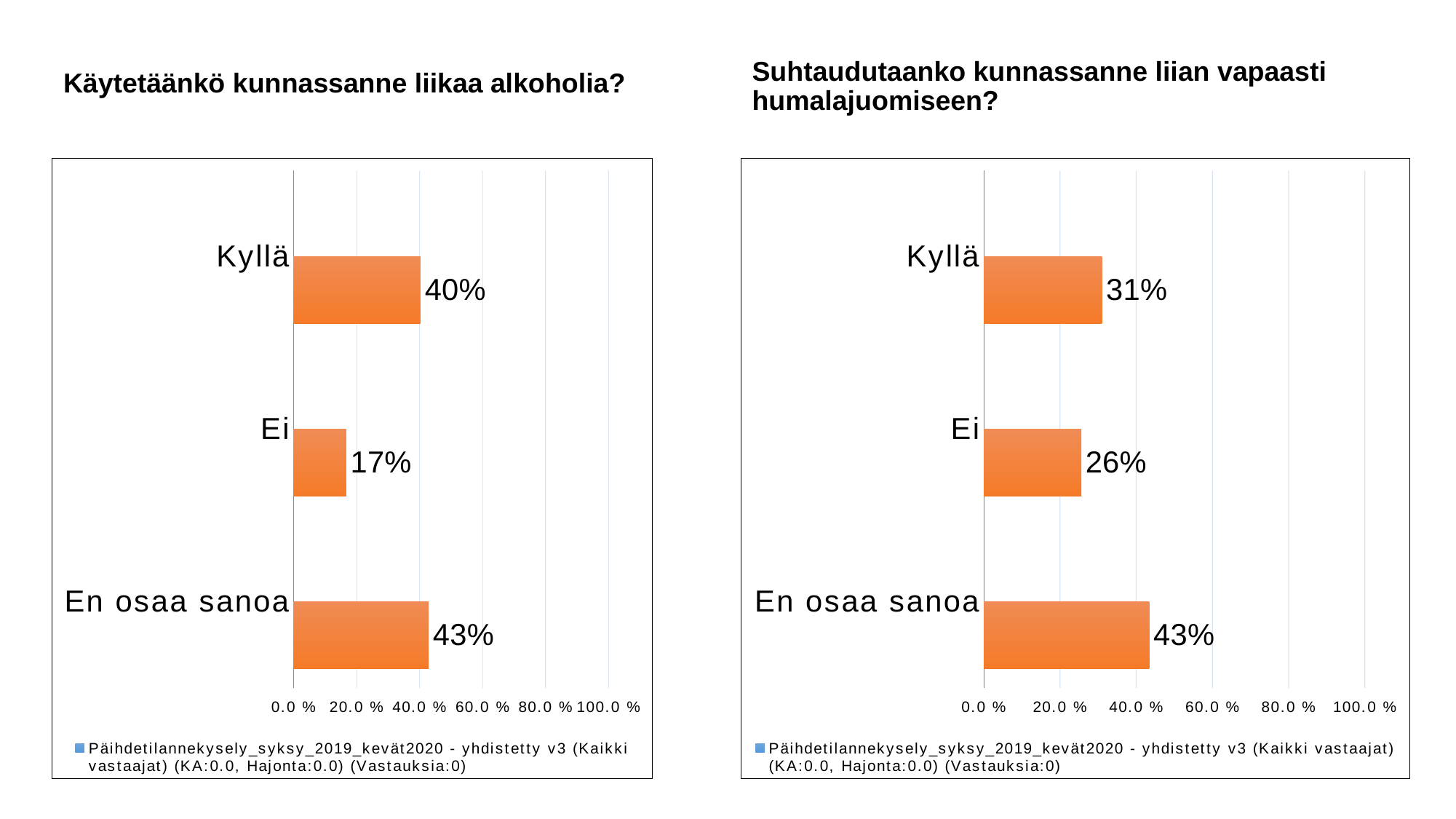
In the chart titled "Käytetäänkö kunnassanne liikaa alkoholia?", which category has the lowest value? Ei In the chart titled "Suhtaudutaanko kunnassanne liian vapaasti humalajuomiseen?", what is the difference between the values for Kyllä and Ei? 5% In the chart titled "Käytetäänkö kunnassanne liikaa alkoholia?", what is the difference between the values for En osaa sanoa and Kyllä? 3% In the chart titled "Käytetäänkö kunnassanne liikaa alkoholia?", what is the value for Ei? 17% In the chart titled "Suhtaudutaanko kunnassanne liian vapaasti humalajuomiseen?", what is the value for Kyllä? 31% What kind of chart is the chart titled "Suhtaudutaanko kunnassanne liian vapaasti humalajuomiseen?"? Bar chart In the chart titled "Suhtaudutaanko kunnassanne liian vapaasti humalajuomiseen?", is the value for Ei greater or less than 40.0 %? less In the chart titled "Suhtaudutaanko kunnassanne liian vapaasti humalajuomiseen?", what is the value for En osaa sanoa? 43% How many categories are shown in the chart titled "Käytetäänkö kunnassanne liikaa alkoholia?"? 3 In the chart titled "Suhtaudutaanko kunnassanne liian vapaasti humalajuomiseen?", which category has the highest value? En osaa sanoa In the chart titled "Käytetäänkö kunnassanne liikaa alkoholia?", which is larger, the value for Kyllä or the value for Ei? Kyllä In the chart titled "Käytetäänkö kunnassanne liikaa alkoholia?", what is the value for Kyllä? 40%